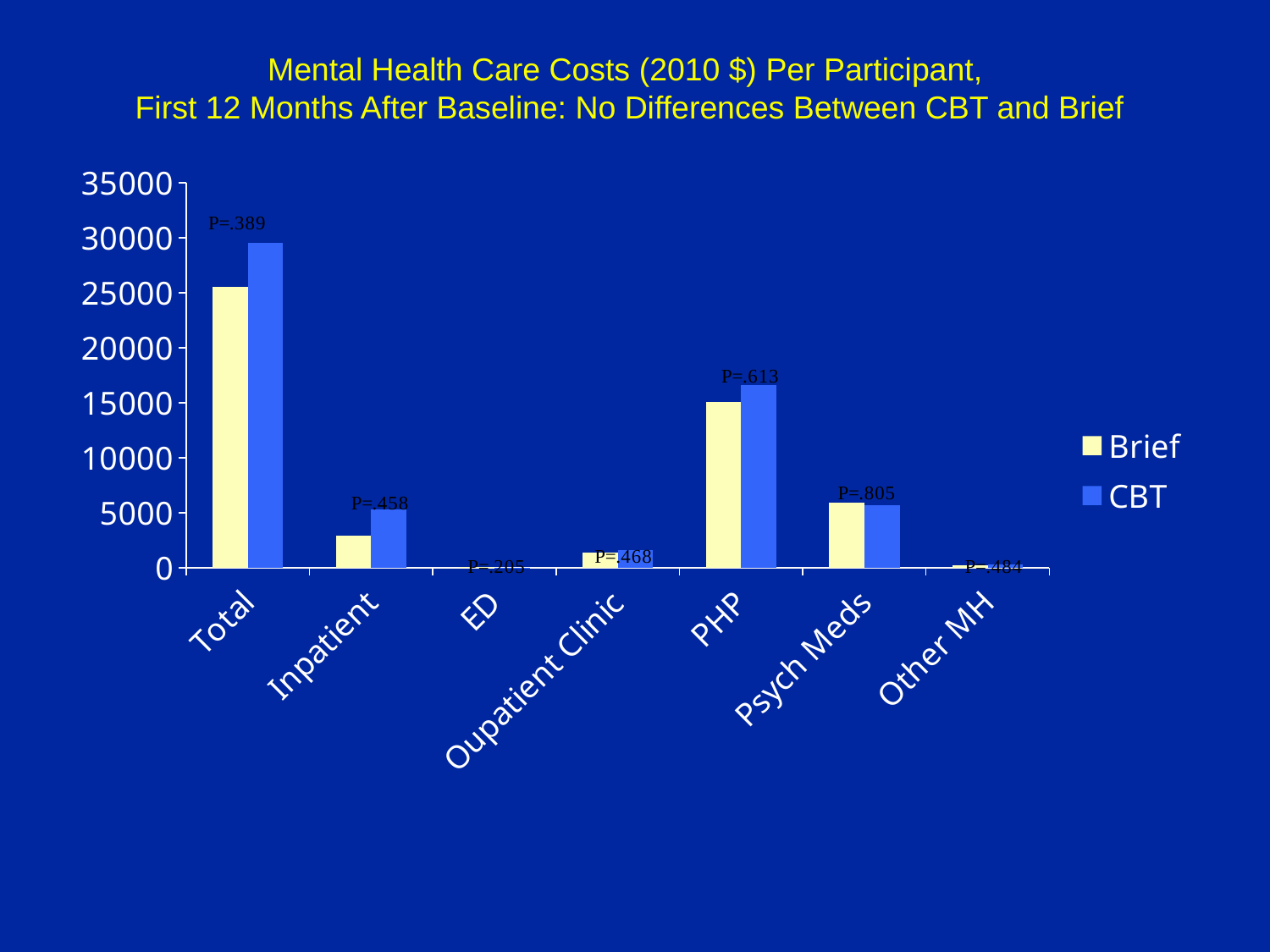
Is the Brief value for Inpatient greater or less than 5000? less How many categories are shown on the x axis of the chart? 7 For the Total category, which series has the larger value, Brief or CBT? CBT For the Inpatient category, which series has the larger value, Brief or CBT? CBT Is the Brief value for Total greater or less than 20000? greater What P-value is printed above the Total bars? P=.389 Which category has the highest cost for the Brief series? Total Is the CBT value for PHP greater or less than 15000? greater Which category has the highest cost for the CBT series? Total What P-value is printed above the PHP bars? P=.613 How many series does the legend list? 2 What kind of chart is shown on the slide? bar chart